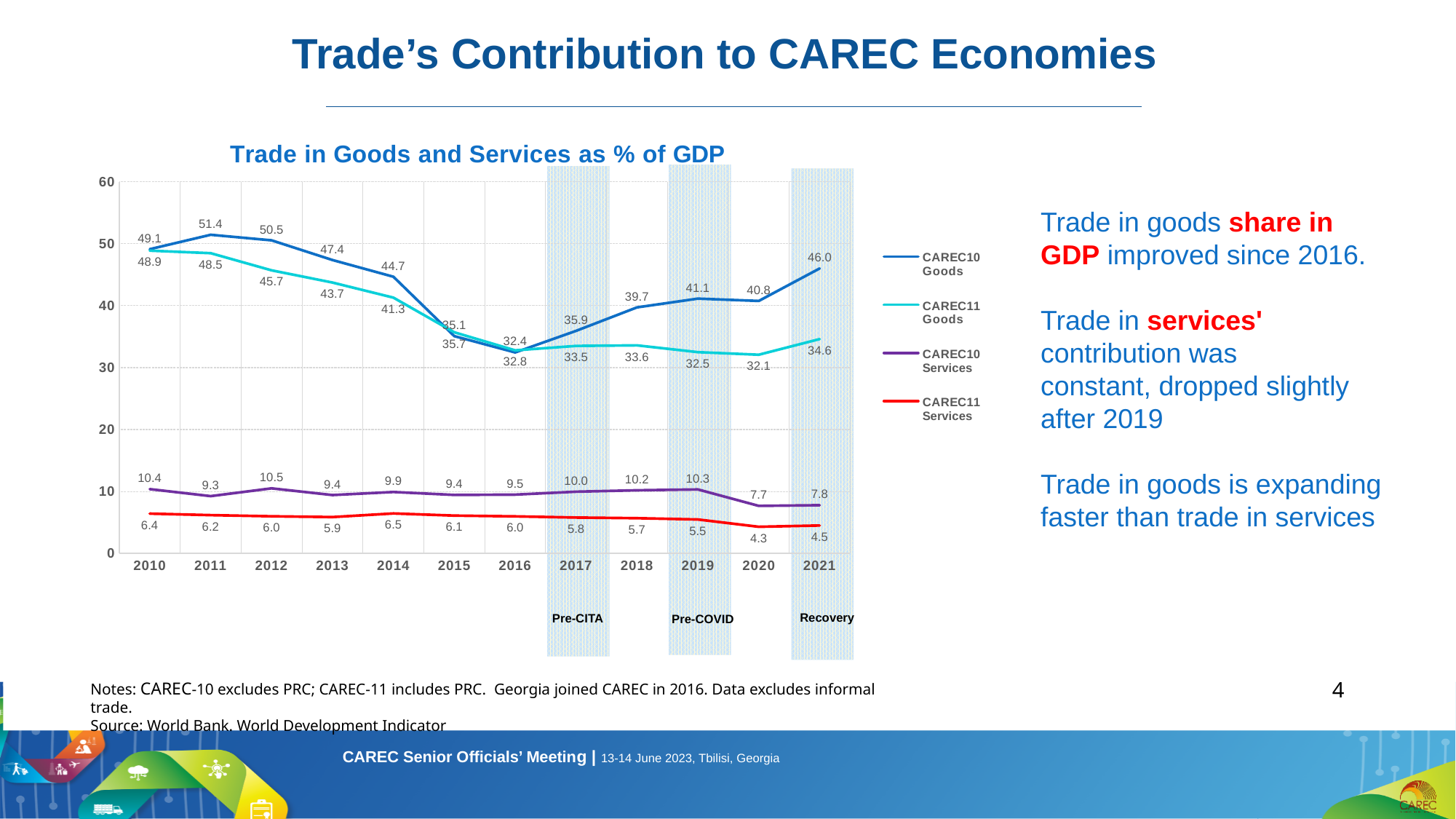
How many years are shown on the x axis of the chart? 12 In which year is CAREC10 Goods at its highest? 2011 What are the three labels given to the shaded periods below the x axis? Pre-CITA, Pre-COVID, Recovery What is the value for CAREC11 Services in 2020? 4.3 What is the value for CAREC10 Services in 2012? 10.5 By how much did CAREC10 Goods increase from 2016 to 2021? 13.6 Does CAREC10 Goods rise or fall between 2011 and 2016? Fall What is the value for CAREC10 Goods in 2021? 46.0 How many series does the legend of the chart list? 4 What kind of chart is shown on the slide? Line chart In 2019, which is larger: CAREC10 Goods or CAREC11 Goods? CAREC10 Goods In which year is CAREC11 Services at its lowest? 2020